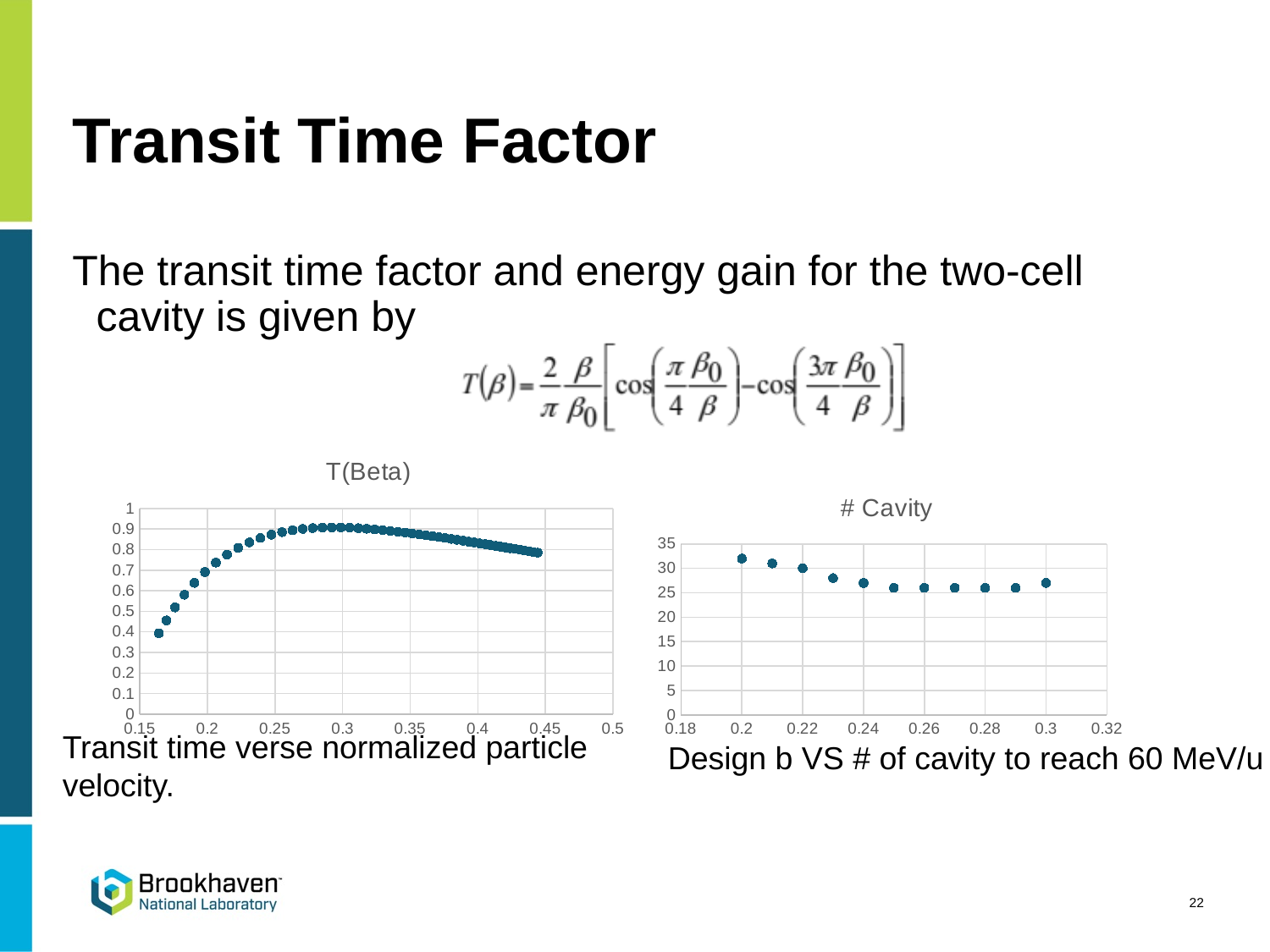
In the "# Cavity" chart, which has the larger value: x = 0.2 or x = 0.3? 0.2 In the "# Cavity" chart, how many data points are plotted? 11 What kind of chart is the "# Cavity" chart on the right? scatter chart What kind of chart is the "T(Beta)" chart on the left? scatter chart In the "T(Beta)" chart, is the value at x = 0.3 greater or less than 0.8? greater In the "# Cavity" chart, do the values rise or fall as x goes from 0.2 to 0.25? fall In the "# Cavity" chart, is the value at x = 0.25 greater or less than 30? less In the "# Cavity" chart, is the value at x = 0.2 greater or less than 30? greater In the "T(Beta)" chart, do the values rise or fall as x goes from 0.15 to 0.25? rise In the "# Cavity" chart, at which x value is the number of cavities highest? 0.2